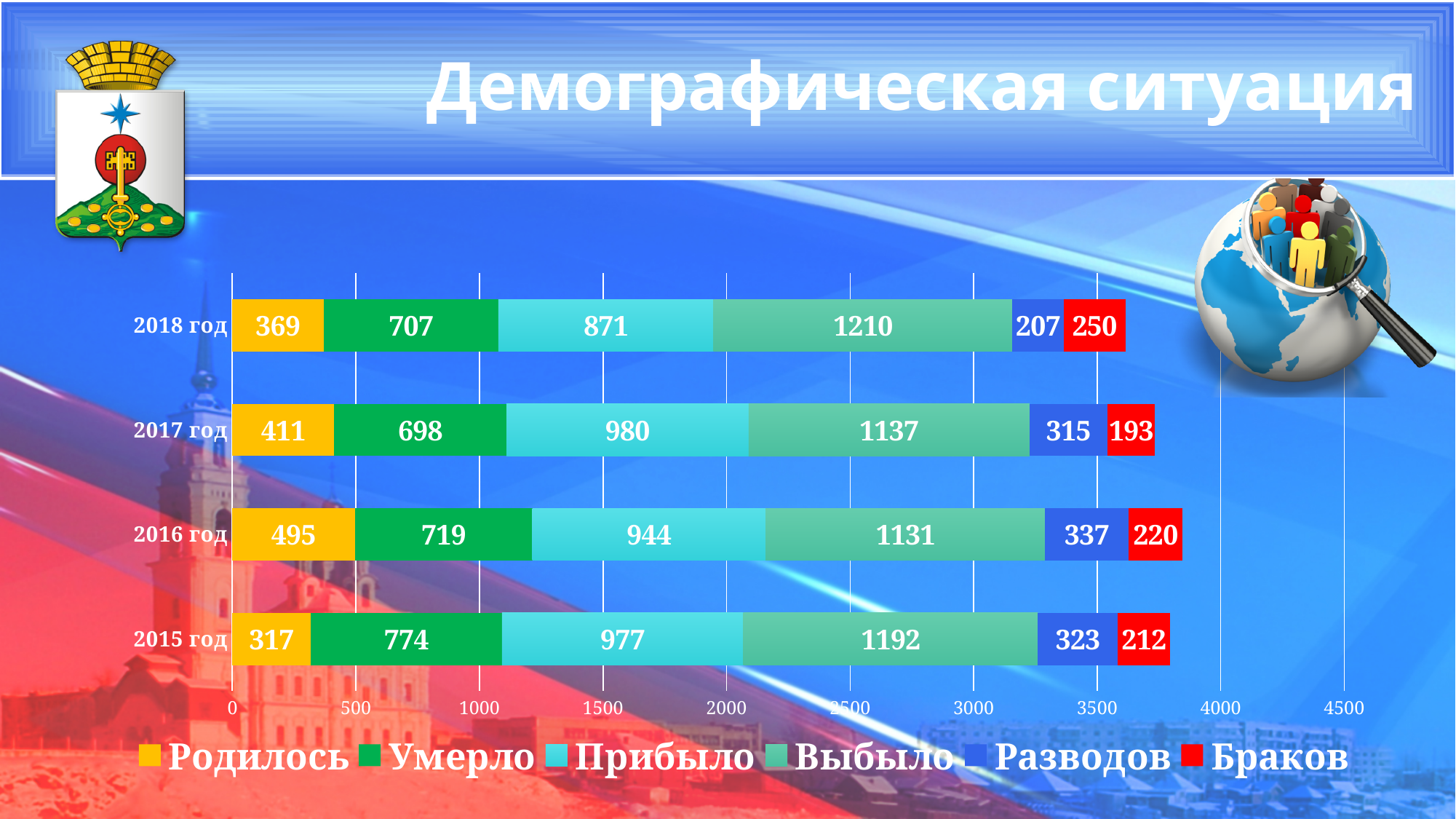
In which year is the value for Браков the lowest? 2017 год What is the difference between Умерло and Родилось in 2018 год? 338 Which is larger in 2016 год: Разводов or Браков? Разводов What is the value for Родилось in 2018 год? 369 How many years are shown on the chart? 4 What is the total of the stacked bar for 2018 год? 3614 What is the value for Выбыло in 2015 год? 1192 What kind of chart is shown on the slide? Stacked bar chart In which year is the value for Родилось the highest? 2016 год How many series does the legend list? 6 What is the value for Разводов in 2017 год? 315 What is the title of the slide? Демографическая ситуация